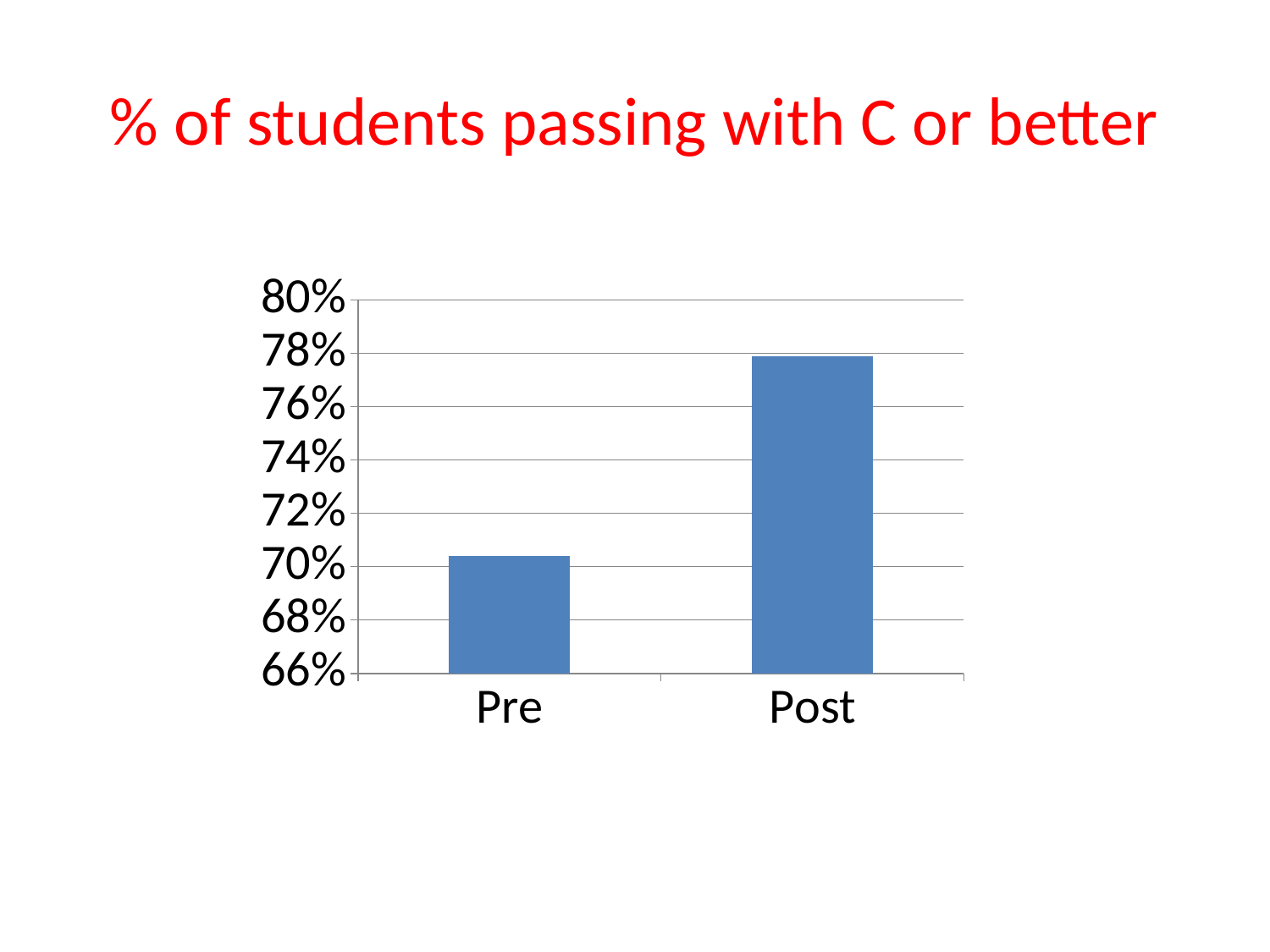
Is the value for Pre greater or less than 68%? greater Is the value for Post greater or less than 76%? greater Which category has the highest value, Pre or Post? Post What is the lowest value shown on the y axis? 66% What is the title of the chart? % of students passing with C or better Do the values rise or fall from Pre to Post? rise Is the value for Post greater or less than 80%? less Which category has the lowest value? Pre What kind of chart is shown on the slide? bar chart Is the value for Post larger than the value for Pre? yes How many categories are shown on the x axis? 2